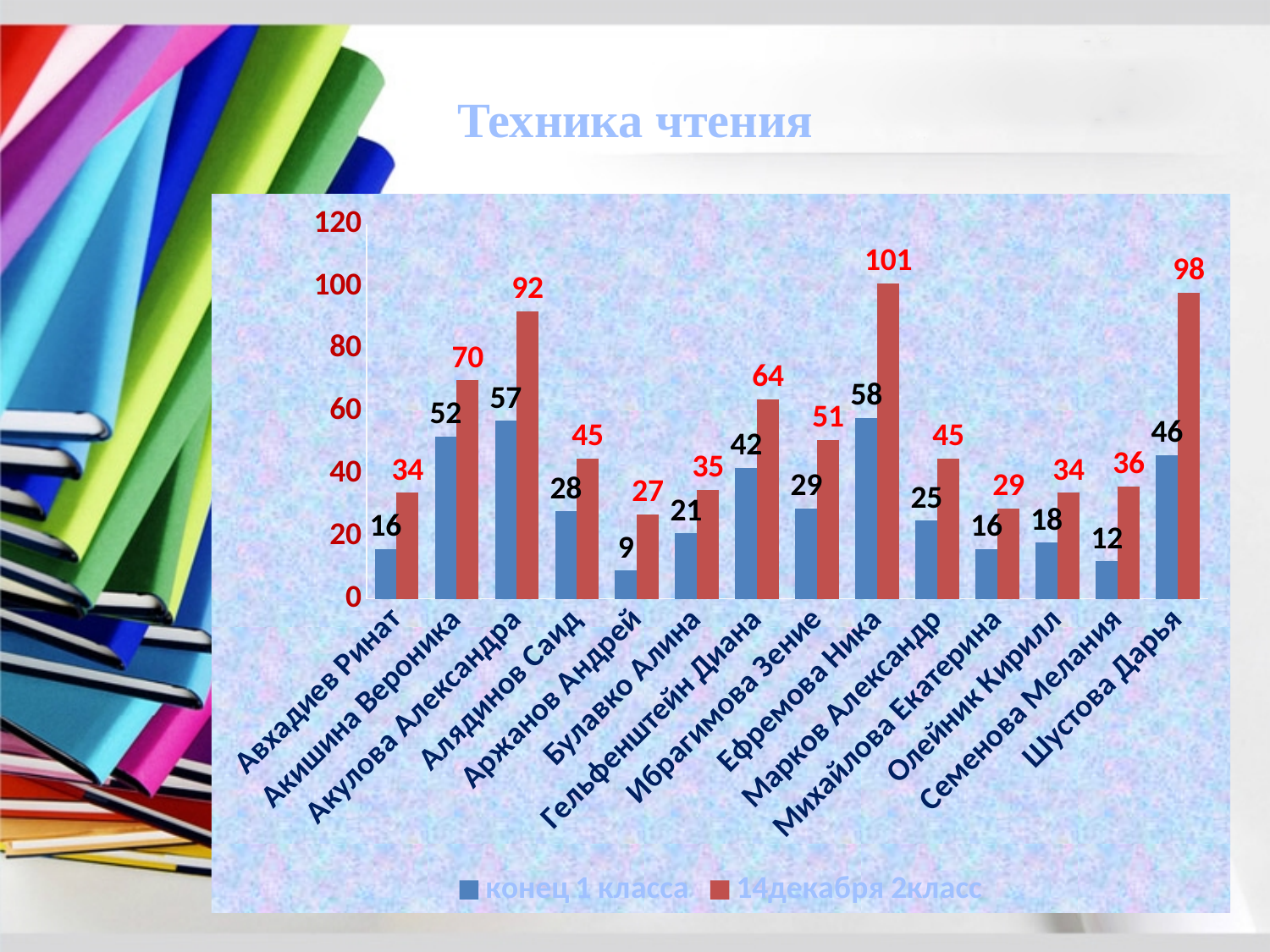
What is the difference between the '14декабря 2класс' and 'конец 1 класса' values for Ефремова Ника? 43 What is the value for Акулова Александра in the series '14декабря 2класс'? 92 How many students are shown on the x axis? 14 What is the value for Шустова Дарья in the series '14декабря 2класс'? 98 Is the '14декабря 2класс' value for Семенова Мелания greater or less than 40? less Which student has the lowest value in the series 'конец 1 класса'? Аржанов Андрей Which is larger: the 'конец 1 класса' value for Акишина Вероника or for Гельфенштейн Диана? Акишина Вероника How many series does the legend list? 2 What is the value for Аржанов Андрей in the series 'конец 1 класса'? 9 Which student has the highest value in the series '14декабря 2класс'? Ефремова Ника What kind of chart is shown on the slide? bar chart What is the title of the slide above the chart? Техника чтения